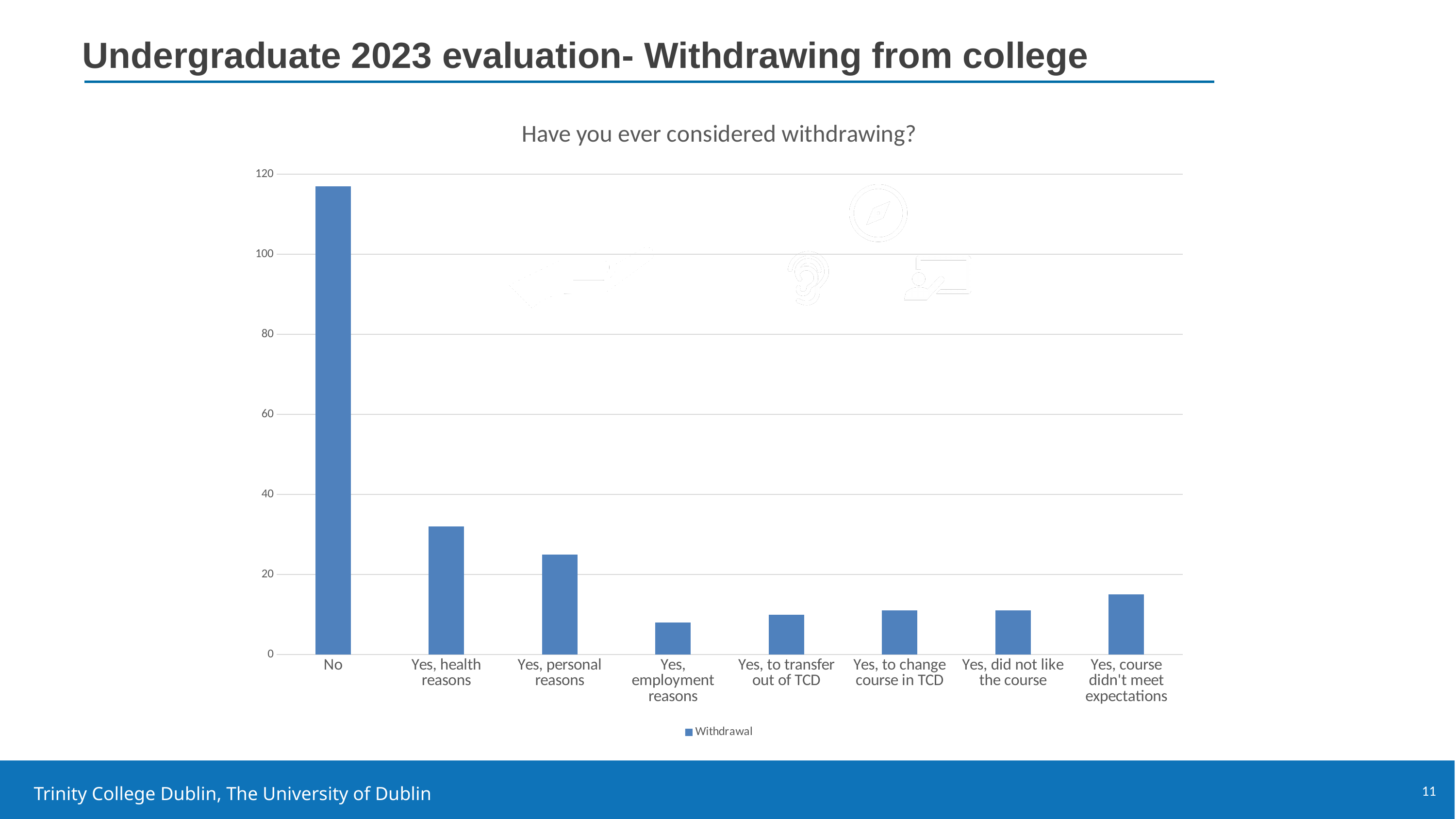
How many categories are shown on the x axis of the chart? 8 Which is larger, the value for "Yes, health reasons" or "Yes, personal reasons"? Yes, health reasons Is the value for "No" greater or less than 100? greater What kind of chart is shown on the slide? bar chart Which category has the highest value? No What is the name of the series shown in the legend? Withdrawal What is the title of the chart? Have you ever considered withdrawing? How many series does the legend list? 1 Is the value for "Yes, health reasons" greater or less than 40? less Which is larger, the value for "Yes, course didn't meet expectations" or "Yes, employment reasons"? Yes, course didn't meet expectations Is the value for "Yes, health reasons" greater or less than 20? greater